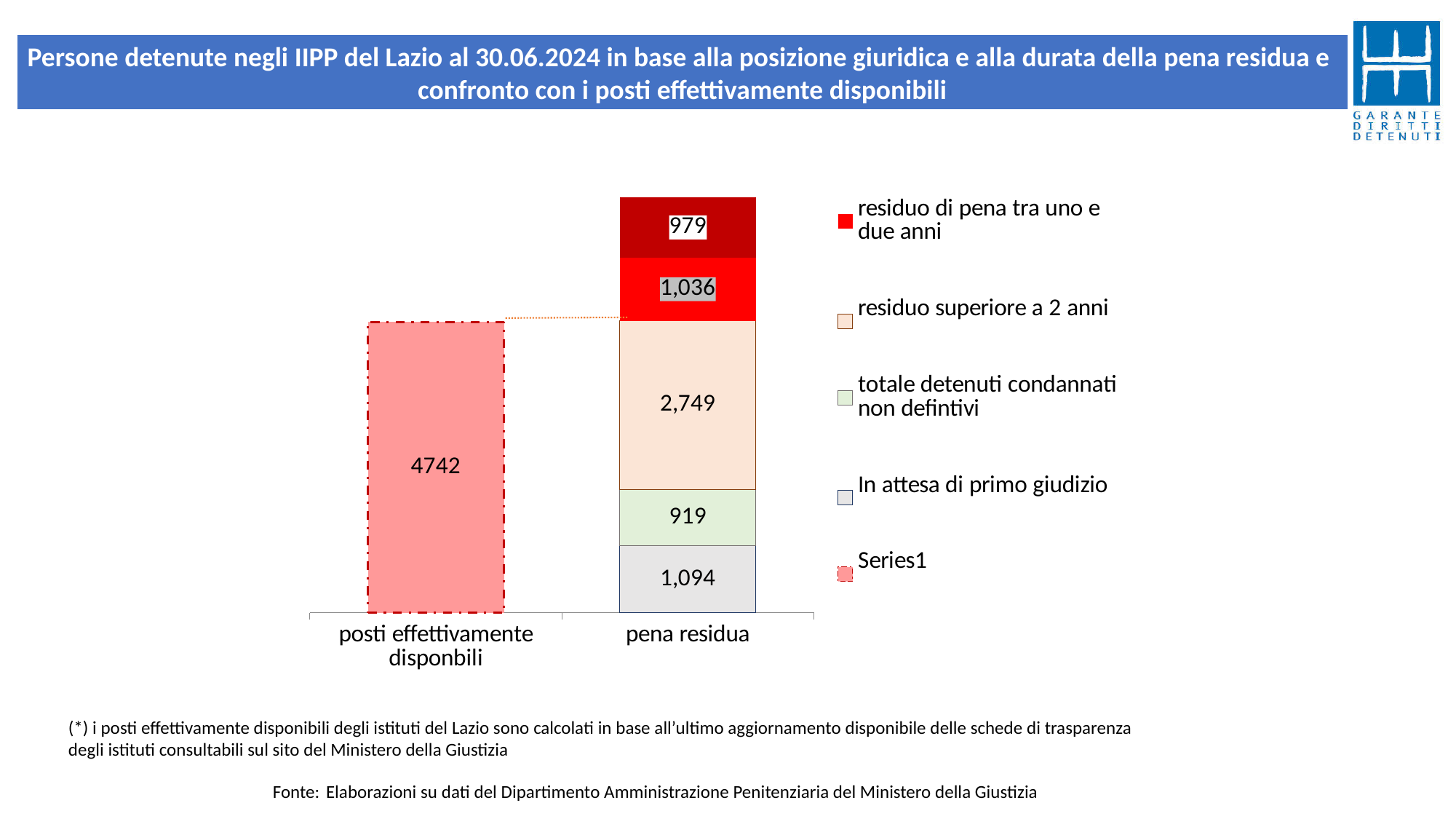
Which is larger in the 'pena residua' bar: 'residuo superiore a 2 anni' or 'totale detenuti condannati non defintivi'? residuo superiore a 2 anni In the 'pena residua' bar, what is the value of the 'residuo superiore a 2 anni' segment? 2,749 What kind of chart is shown on the slide? stacked bar chart In the 'pena residua' bar, what is the value of the 'totale detenuti condannati non defintivi' segment? 919 Which segment of the 'pena residua' bar has the largest value? residuo superiore a 2 anni In the 'pena residua' bar, what is the value of the 'residuo di pena tra uno e due anni' segment? 1,036 What is the value shown for 'posti effettivamente disponbili'? 4742 How many categories are shown on the x axis? 2 What is the total of all segments in the 'pena residua' stacked bar? 6,777 How many entries does the legend list? 5 What is the difference between the 'residuo superiore a 2 anni' segment and the 'In attesa di primo giudizio' segment in the 'pena residua' bar? 1,655 In the 'pena residua' bar, what is the value of the 'In attesa di primo giudizio' segment? 1,094